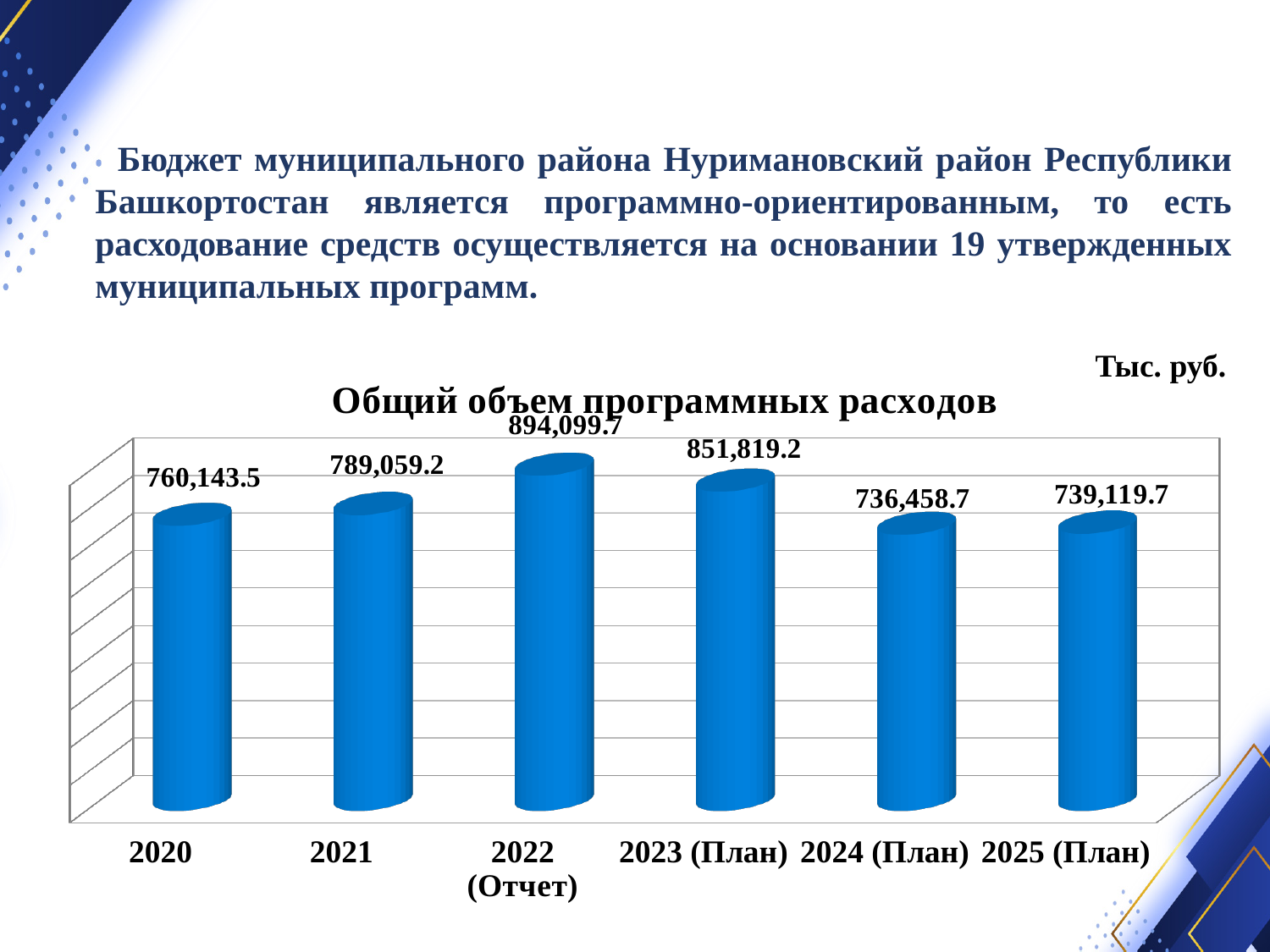
Do the values rise or fall from 2020 to 2022 (Отчет)? Rise What is the value for 2024 (План)? 736,458.7 What is the value for 2022 (Отчет)? 894,099.7 What is the difference between the values for 2022 (Отчет) and 2023 (План)? 42,280.5 What is the value for 2020 in the chart "Общий объем программных расходов"? 760,143.5 What unit is indicated for the chart values? Тыс. руб. How many years (categories) are shown in the chart? 6 Which year has the lowest value in the chart? 2024 (План) Which year has the highest value in the chart? 2022 (Отчет) What is the difference between the values for 2021 and 2020? 28,915.7 What kind of chart is shown on the slide? Bar chart Which is larger, the value for 2024 (План) or 2025 (План)? 2025 (План)